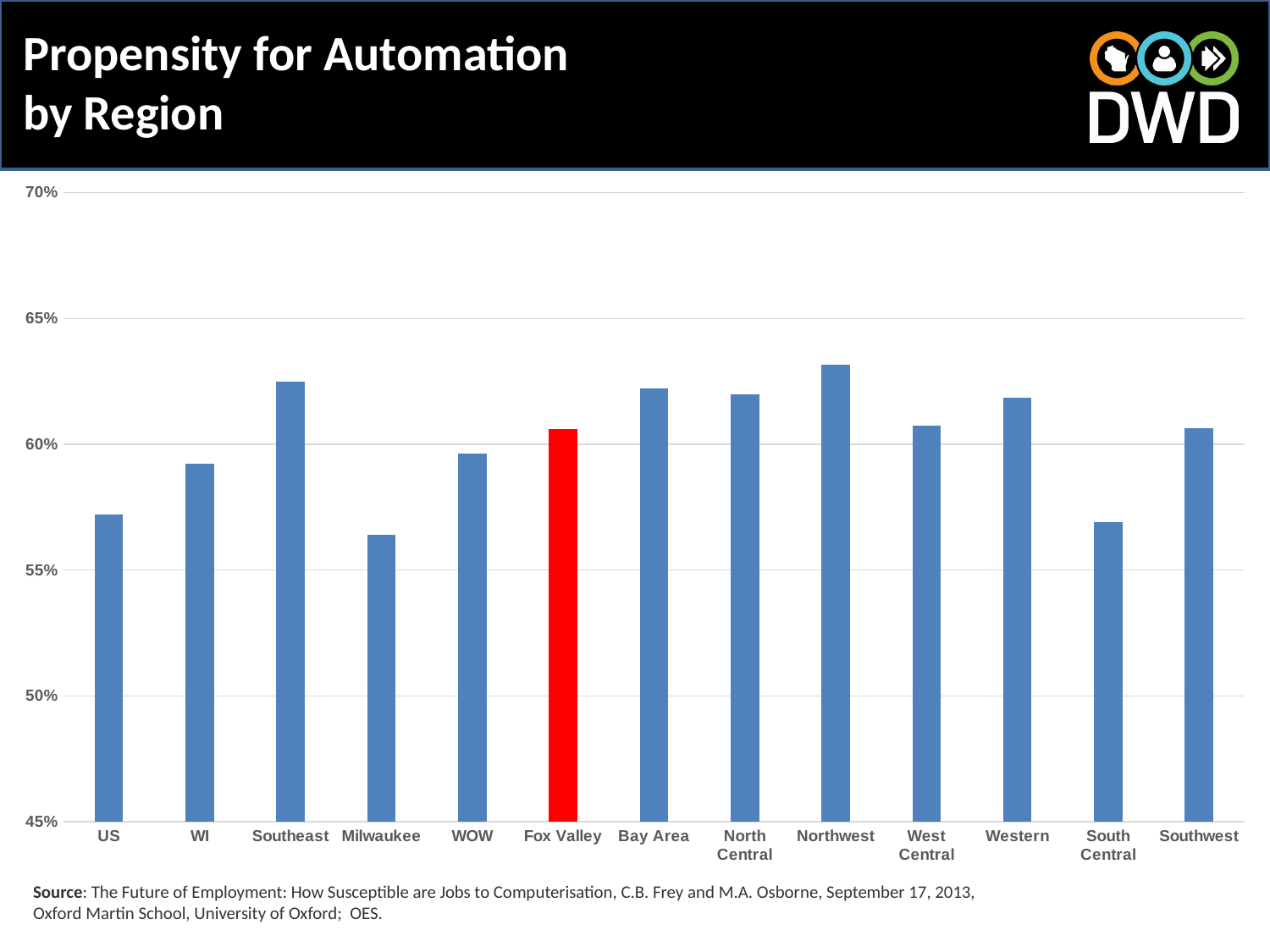
Which bar is highlighted in red on the chart? Fox Valley How many regions (bars) are shown on the chart? 13 Which is larger, the value for Southeast or the value for Milwaukee? Southeast Is the value for South Central greater or less than 60%? less Is the value for US greater or less than 55%? greater Which region has the highest propensity for automation? Northwest Which is larger, the value for WI or the value for US? WI What kind of chart is shown on the slide? bar chart Is the value for Northwest greater or less than 60%? greater Which region has the lowest propensity for automation? Milwaukee What is the title of the chart on the slide? Propensity for Automation by Region